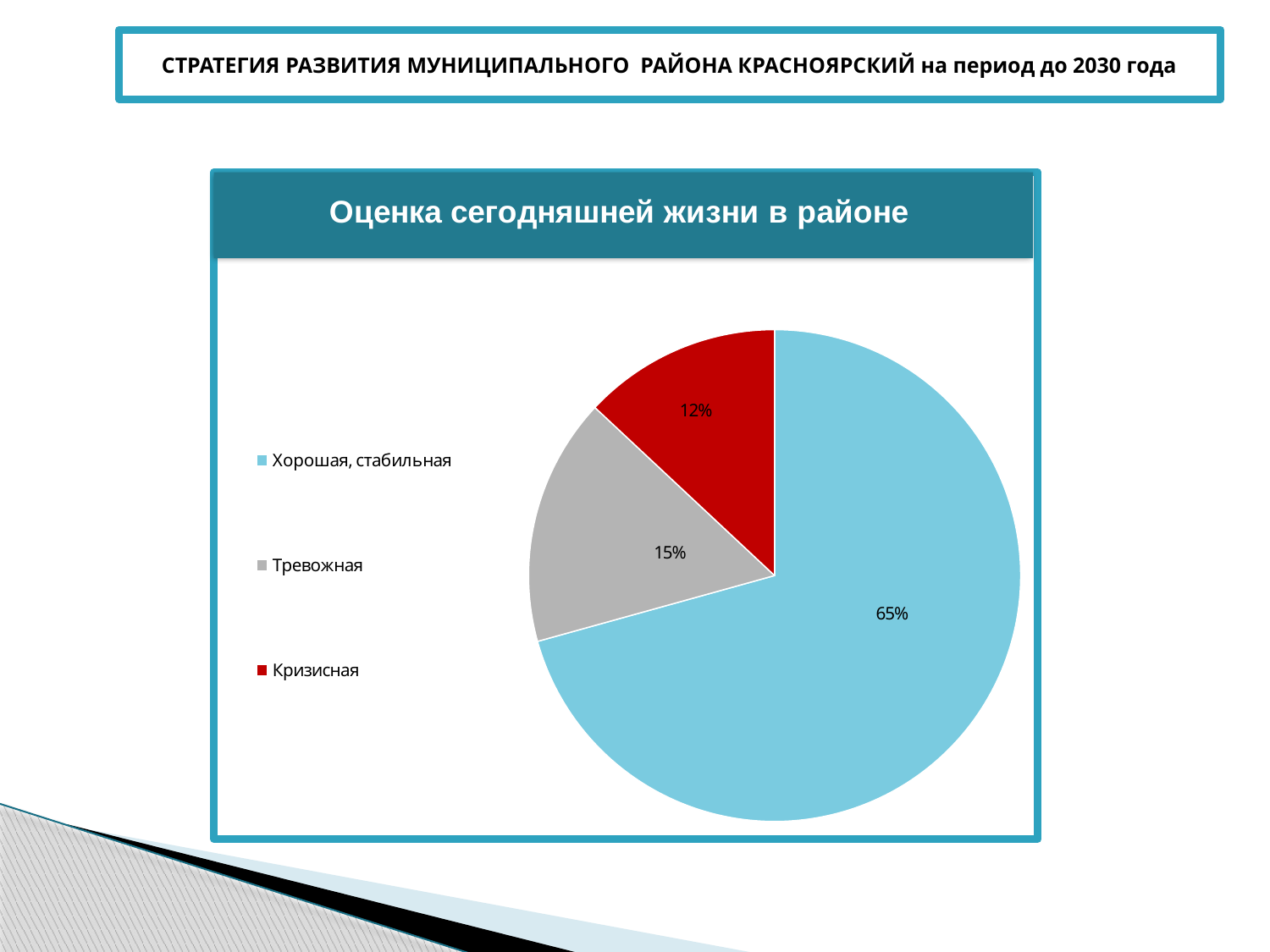
What is the title of the chart? Оценка сегодняшней жизни в районе Which category has the largest slice of the pie? Хорошая, стабильная What colour is the slice for "Кризисная"? red What share of the pie is labelled "Кризисная"? 12% What share of the pie is labelled "Тревожная"? 15% Which category has the smallest slice of the pie? Кризисная How many categories does the pie chart show? 3 Which is larger, the share for "Тревожная" or the share for "Кризисная"? Тревожная What share of the pie is labelled "Хорошая, стабильная"? 65% What is the difference between the shares for "Тревожная" and "Кризисная"? 3% What is the difference between the shares for "Хорошая, стабильная" and "Тревожная"? 50% What kind of chart is shown on the slide? pie chart